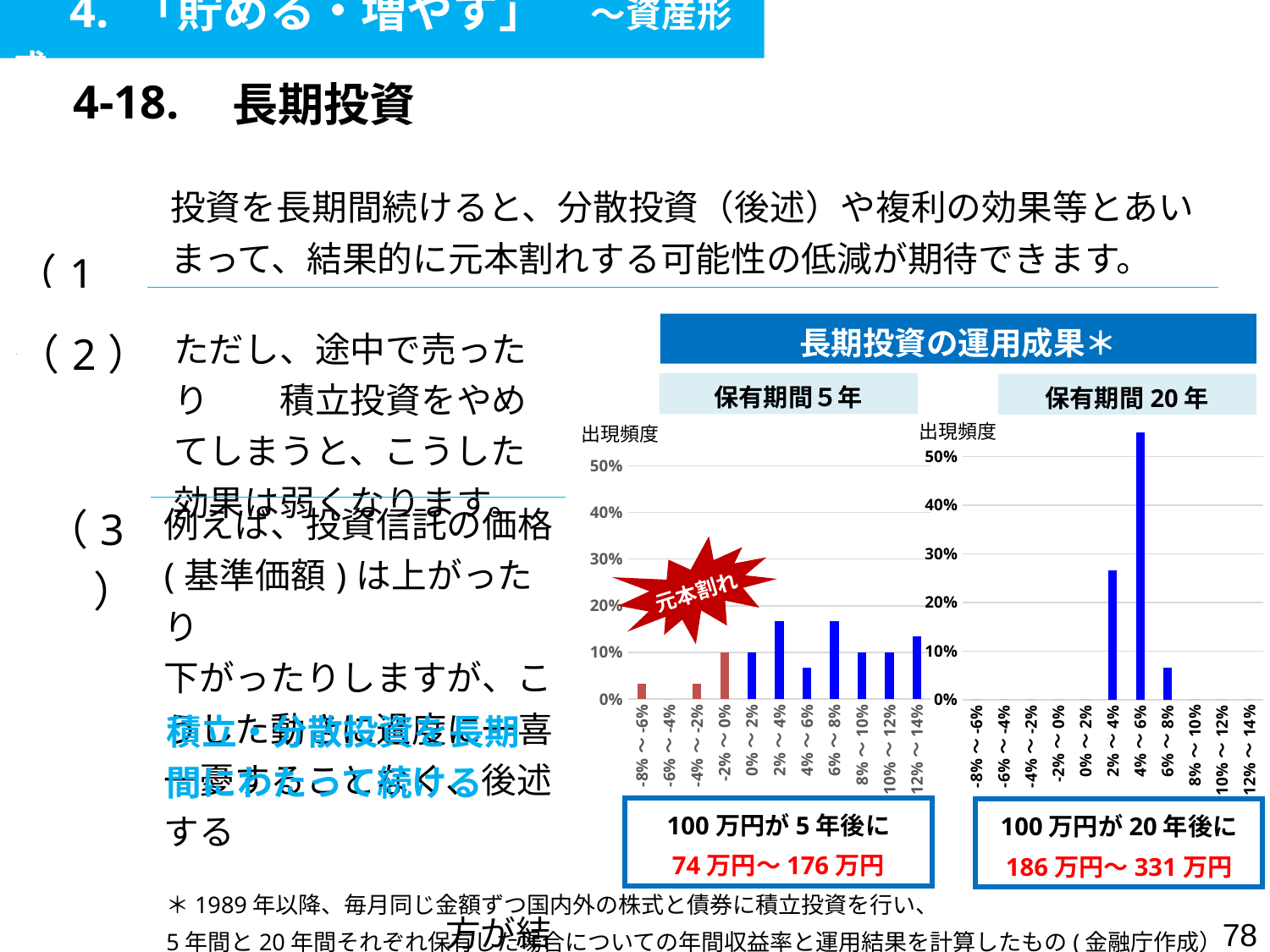
In the 保有期間5年 chart, is the value for 12%～14% greater or less than 10%? greater What is the overall title shown above the two charts? 長期投資の運用成果＊ In the 保有期間20年 chart, is the value for 4%～6% greater or less than 50%? greater How many return-rate categories are shown on the x axis of the 保有期間20年 chart? 11 In the 保有期間20年 chart, which category has the highest frequency? 4%～6% In the 保有期間20年 chart, which is larger, the value for 2%～4% or the value for 6%～8%? 2%～4% In the 保有期間20年 chart, is the value for 2%～4% greater or less than 20%? greater What kind of chart is used for the 保有期間5年 chart? bar chart What is the label of the vertical axis on the 保有期間5年 chart? 出現頻度 In the 保有期間5年 chart, which is larger, the value for 2%～4% or the value for 4%～6%? 2%～4%